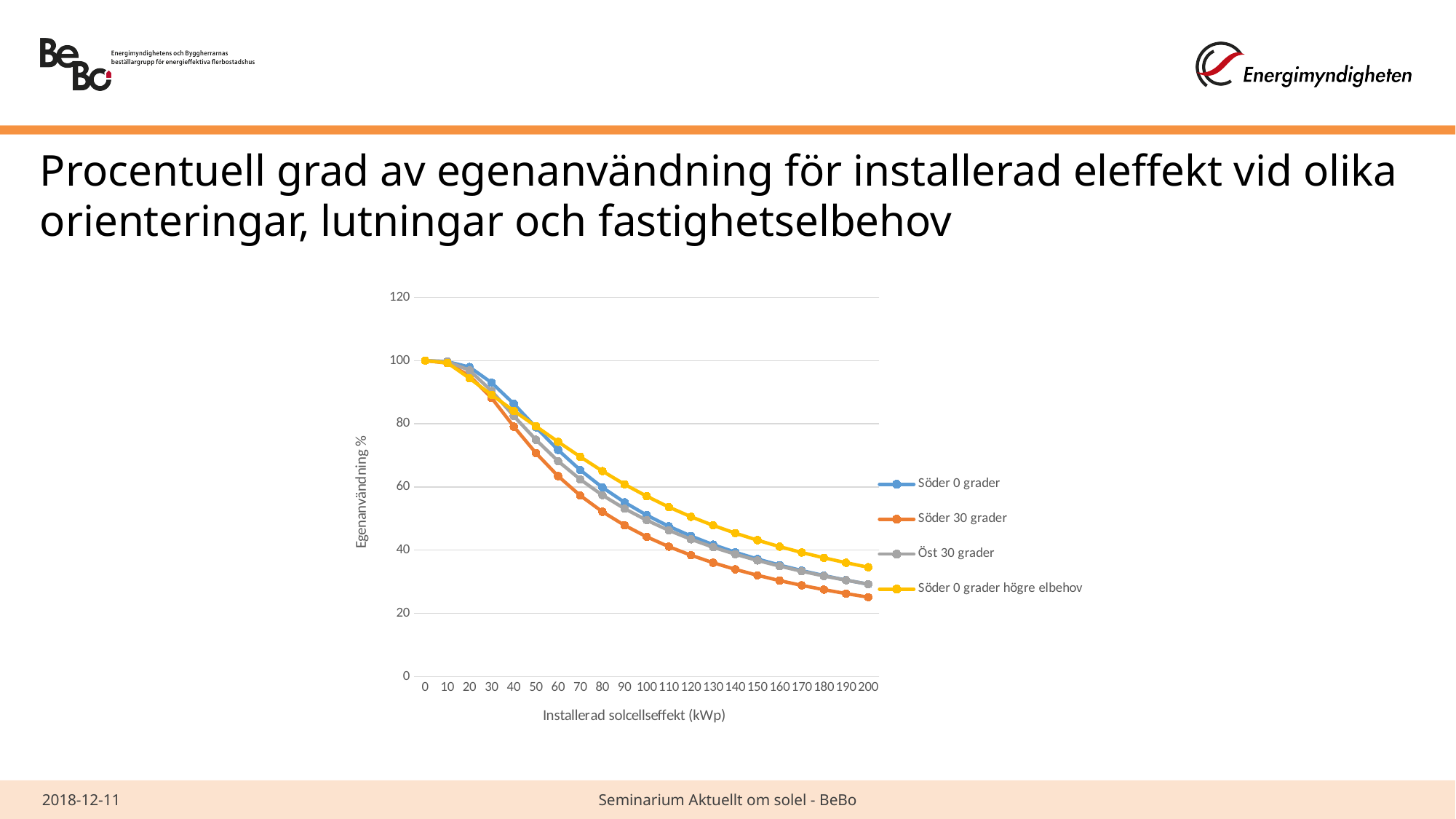
Which series has the highest value at 200 kWp? Söder 0 grader högre elbehov How many series does the legend list? 4 How many points are plotted along the x axis for each series (from 0 to 200 kWp)? 21 What is the label of the y axis? Egenanvändning % What is the label of the x axis? Installerad solcellseffekt (kWp) Is the value for Söder 30 grader at 50 kWp greater or less than 60? greater What kind of chart is shown on the slide? line chart Is the value for Söder 30 grader at 200 kWp greater or less than 40? less What is the value of Egenanvändning % for Söder 0 grader at 0 kWp? 100 Do the values rise or fall as installed solar power (kWp) increases along the x axis? fall At 200 kWp, which is larger: Söder 0 grader högre elbehov or Söder 30 grader? Söder 0 grader högre elbehov Which series has the lowest value at 200 kWp? Söder 30 grader